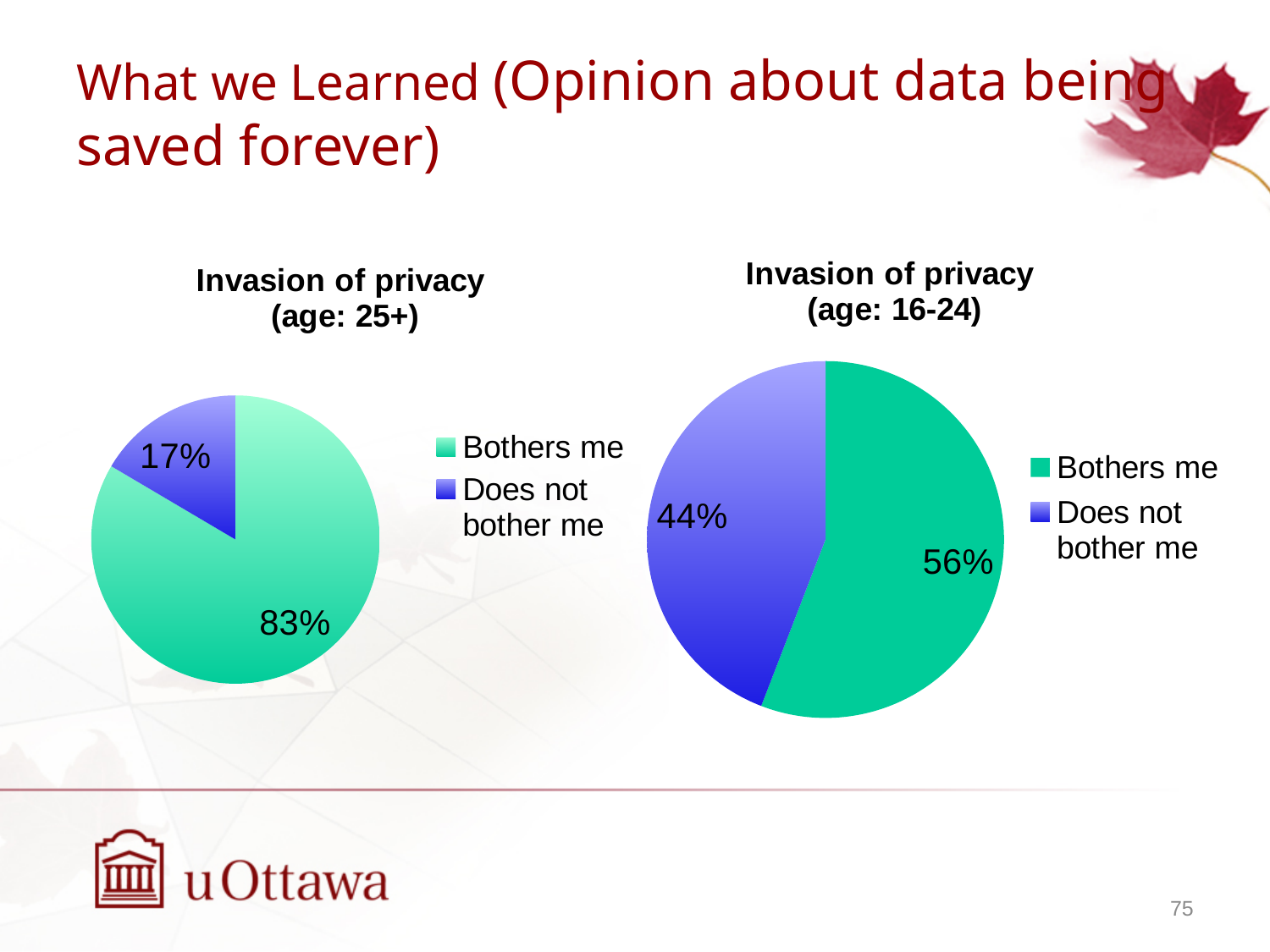
In the 'Invasion of privacy (age: 25+)' chart, which category has the largest slice? Bothers me Which is larger: the 'Bothers me' share in the age 25+ chart or the 'Bothers me' share in the age 16-24 chart? Age 25+ (83%) In the 'Invasion of privacy (age: 16-24)' chart, what is the difference between the 'Bothers me' and 'Does not bother me' shares? 12% In the 'Invasion of privacy (age: 25+)' pie chart, what share is labelled 'Bothers me'? 83% In the 'Invasion of privacy (age: 25+)' pie chart, what share is labelled 'Does not bother me'? 17% In the 'Invasion of privacy (age: 16-24)' chart, which category has the smallest slice? Does not bother me In the 'Invasion of privacy (age: 25+)' chart, what is the difference between the 'Bothers me' and 'Does not bother me' shares? 66% What kind of chart is the 'Invasion of privacy (age: 16-24)' chart? Pie chart In the 'Invasion of privacy (age: 16-24)' pie chart, what share is labelled 'Does not bother me'? 44% In the 'Invasion of privacy (age: 16-24)' chart, what colour is the 'Does not bother me' slice? Blue How many categories does the 'Invasion of privacy (age: 25+)' pie chart show? 2